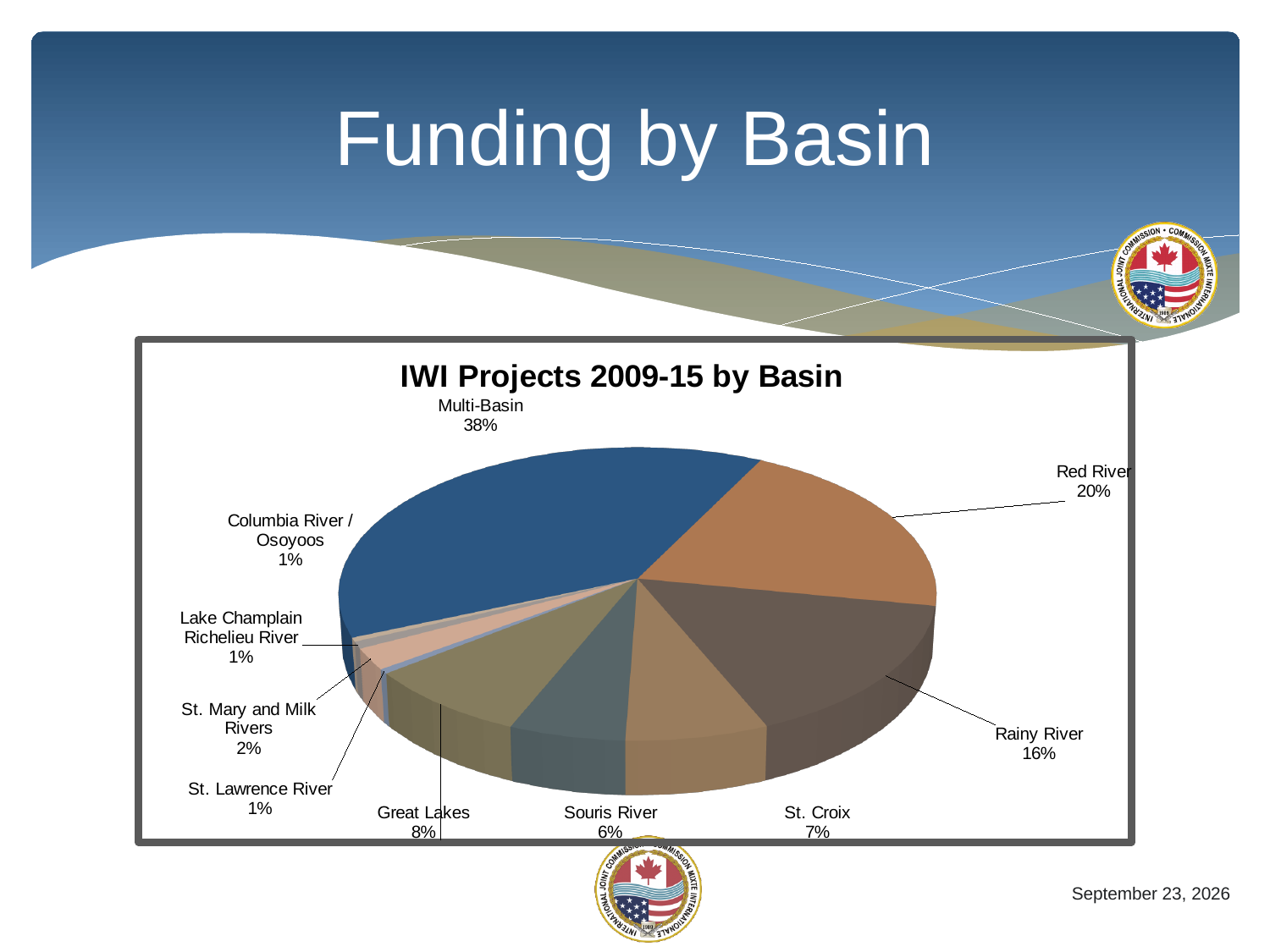
Which basin has the largest share of the pie? Multi-Basin What percentage is shown for Great Lakes? 8% What is the combined share of Multi-Basin and Red River? 58% Which has a larger share, St. Croix or Souris River? St. Croix What share of IWI projects 2009-15 is Multi-Basin? 38% What percentage of the pie does Red River account for? 20% What is the value shown for Rainy River? 16% What is the value for St. Mary and Milk Rivers? 2% What is the title of the chart? IWI Projects 2009-15 by Basin What is the difference in percentage points between Red River and Rainy River? 4 What type of chart is shown on the slide? Pie chart How many slices does the pie chart have? 10